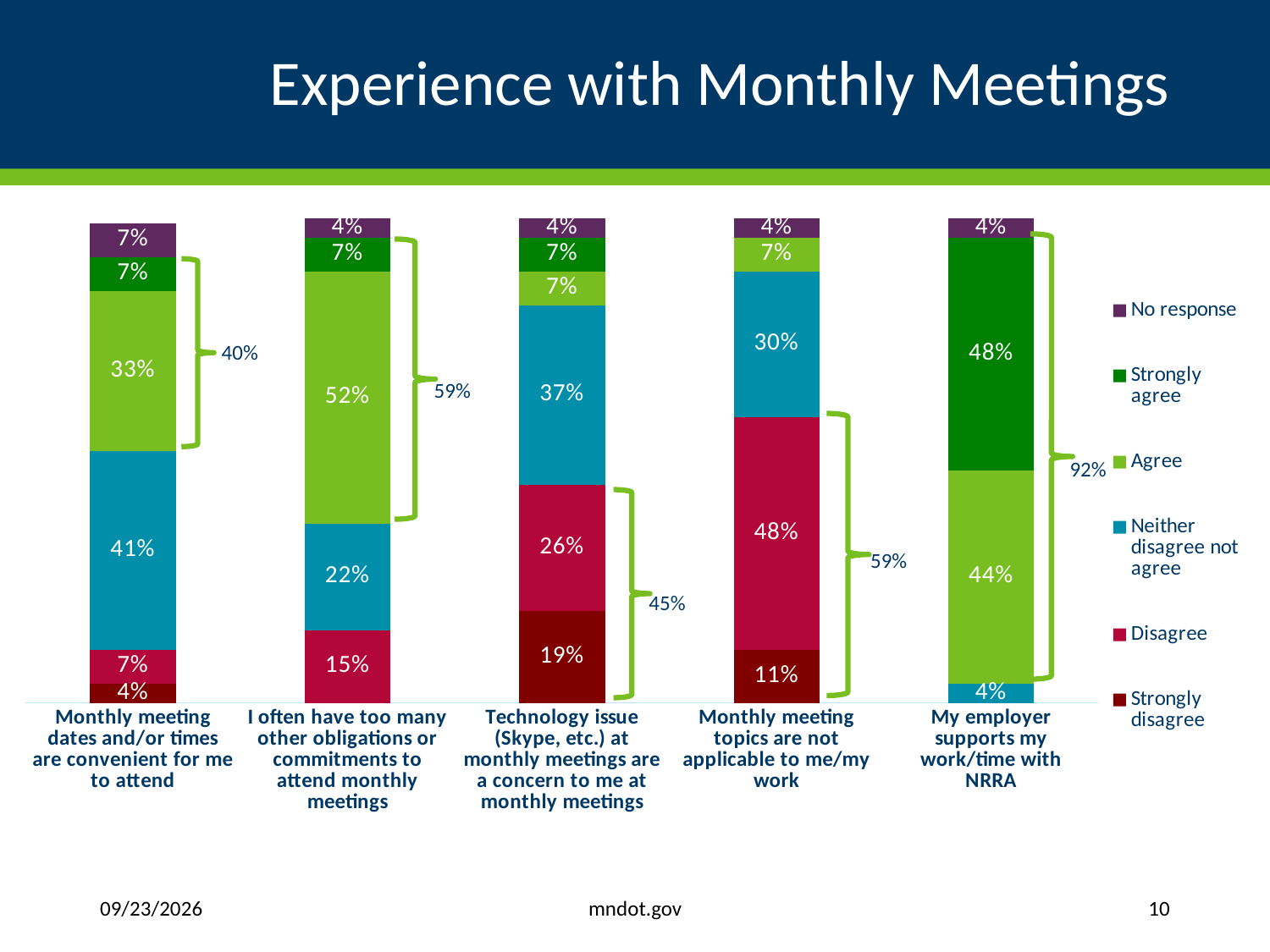
What percentage of respondents answered "Strongly disagree" for "Technology issue (Skype, etc.) at monthly meetings are a concern to me at monthly meetings"? 19% What percentage of respondents answered "Agree" for "I often have too many other obligations or commitments to attend monthly meetings"? 52% What kind of chart is shown on the slide? Stacked bar chart What percentage of respondents answered "Strongly agree" for "My employer supports my work/time with NRRA"? 48% What combined percentage is shown by the bracket next to the "My employer supports my work/time with NRRA" bar? 92% What percentage of respondents answered "Neither disagree not agree" for "Monthly meeting dates and/or times are convenient for me to attend"? 41% Which statement has the highest "Agree" percentage? I often have too many other obligations or commitments to attend monthly meetings How many statements (bars) are shown in the chart? 5 What is the difference between the "Disagree" percentages for "Monthly meeting topics are not applicable to me/my work" and "Technology issue (Skype, etc.) at monthly meetings are a concern to me at monthly meetings"? 22% Which is larger: the "Neither disagree not agree" share for "Monthly meeting dates and/or times are convenient for me to attend" or for "Technology issue (Skype, etc.) at monthly meetings are a concern to me at monthly meetings"? Monthly meeting dates and/or times are convenient for me to attend How many series does the legend list? 6 What percentage of respondents answered "Disagree" for "Monthly meeting topics are not applicable to me/my work"? 48%